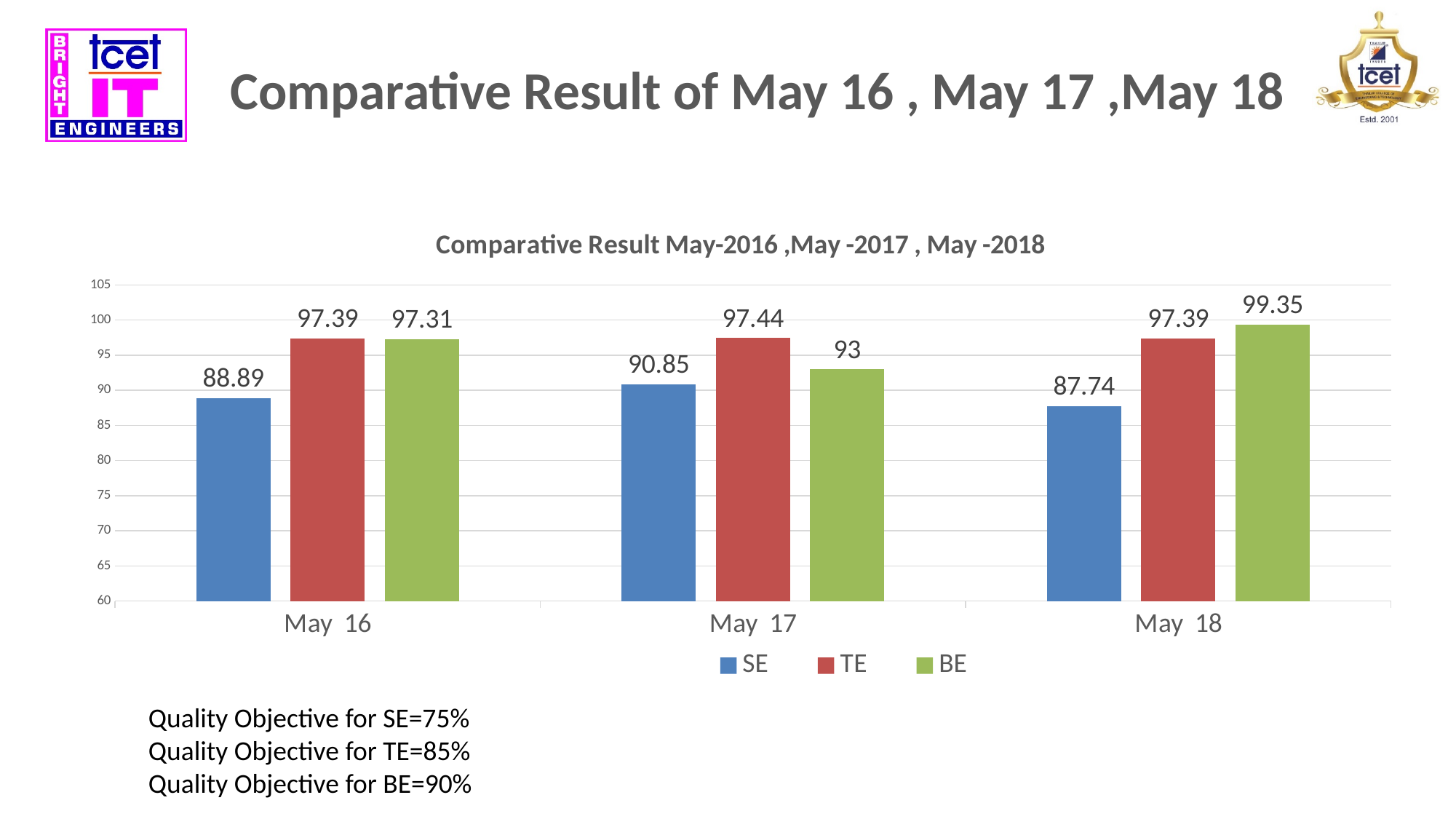
What is the value for BE in May 17? 93 Which series has the highest value in May 18? BE Which series has the lowest value in May 17? SE What is the value for SE in May 16? 88.89 What is the difference between the TE and SE values in May 18? 9.65 What is the title of the chart? Comparative Result May-2016 ,May -2017 , May -2018 What is the value for BE in May 18? 99.35 How many categories are shown on the x axis? 3 Which is larger, the BE value in May 16 or the BE value in May 17? BE in May 16 What kind of chart is shown on the slide? Bar chart What is the value for TE in May 17? 97.44 How many series does the legend list? 3